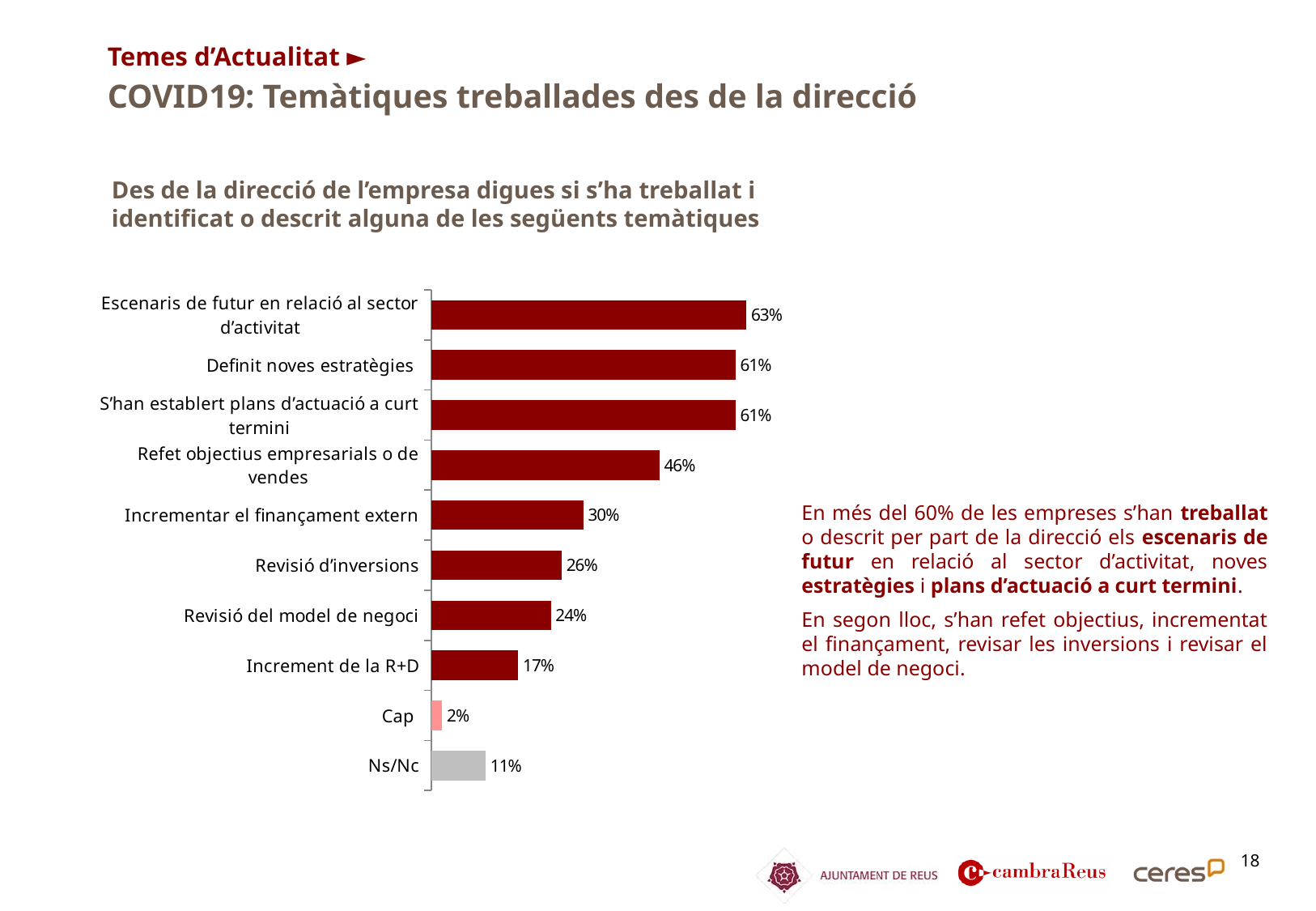
What is the value for "Increment de la R+D"? 17% What percentage is shown for "Ns/Nc"? 11% What percentage is shown for "Definit noves estratègies"? 61% Which bar is shown in grey rather than dark red? Ns/Nc What is the difference between "Refet objectius empresarials o de vendes" and "Revisió d'inversions"? 20% Which category has the highest value? Escenaris de futur en relació al sector d'activitat Which category has the lowest value? Cap Which is larger, "Revisió del model de negoci" or "Increment de la R+D"? Revisió del model de negoci How many categories are shown in the bar chart? 10 What is the difference between the highest value and "Cap"? 61% What kind of chart is shown on the slide? Bar chart What is the value for "Incrementar el finançament extern"? 30%